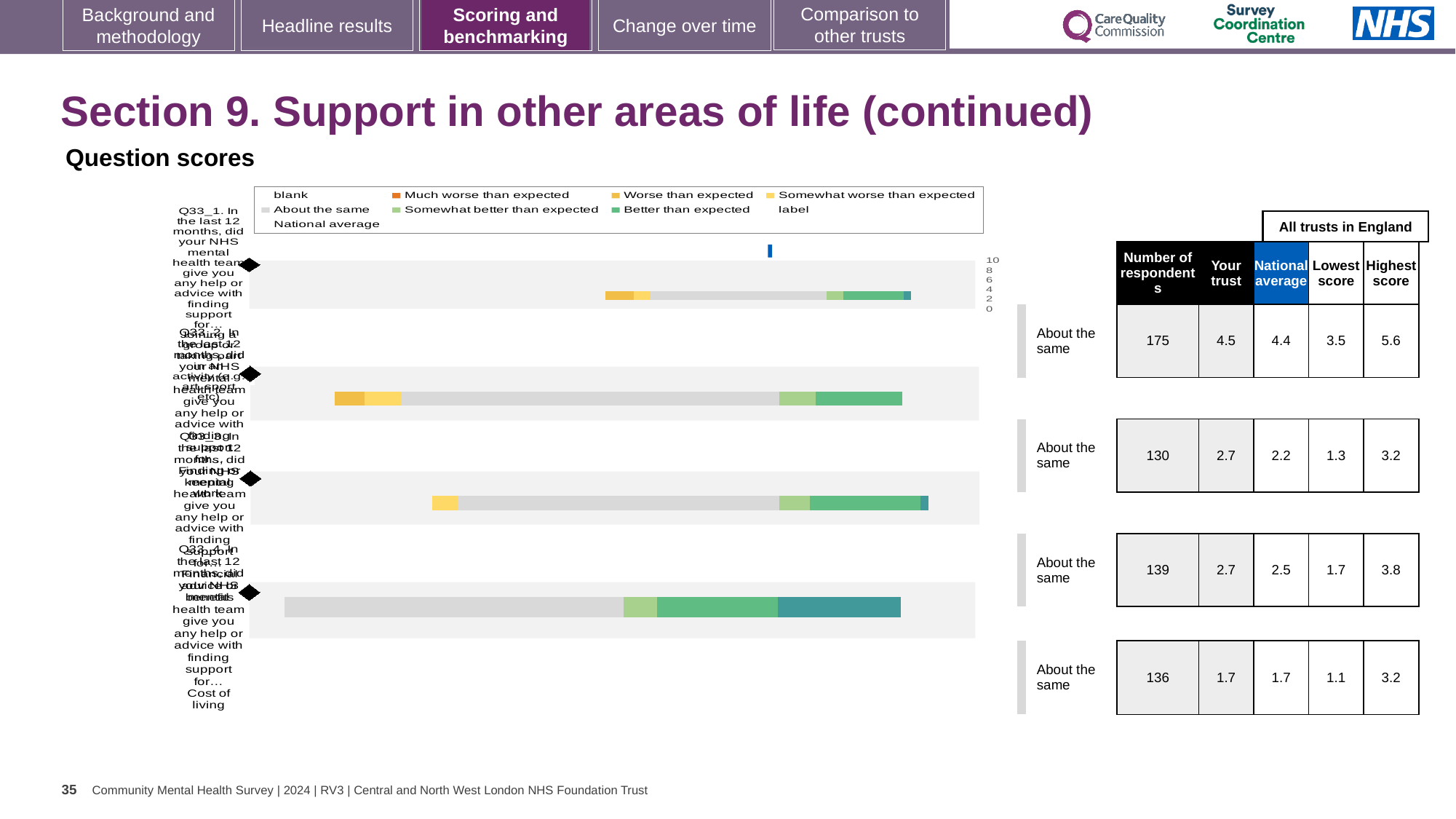
What kind of chart is shown on the slide? Bar chart In the table beside the chart, what is the highest score for the first question (Q33_1)? 5.6 According to the table next to the chart, how is the trust's result described for every question shown? About the same In the table beside the chart, how many respondents are listed for the first question (Q33_1)? 175 What colour represents 'Much worse than expected' in the chart legend? Orange Which question row has the highest 'Your trust' score in the table beside the chart? Q33_1 (4.5) In the table beside the chart, what is the national average for the first question (Q33_1)? 4.4 How many entries does the chart legend list? 9 For the second question row (Q33_2), what is the difference between the 'Your trust' score (2.7) and the national average (2.2)? 0.5 How many questions (bars) are plotted in the chart? 4 Which question row has the lowest number of respondents in the table beside the chart? Q33_2 (130) In the table beside the chart, what is the 'Your trust' score for the last question (Q33_4, Cost of living)? 1.7